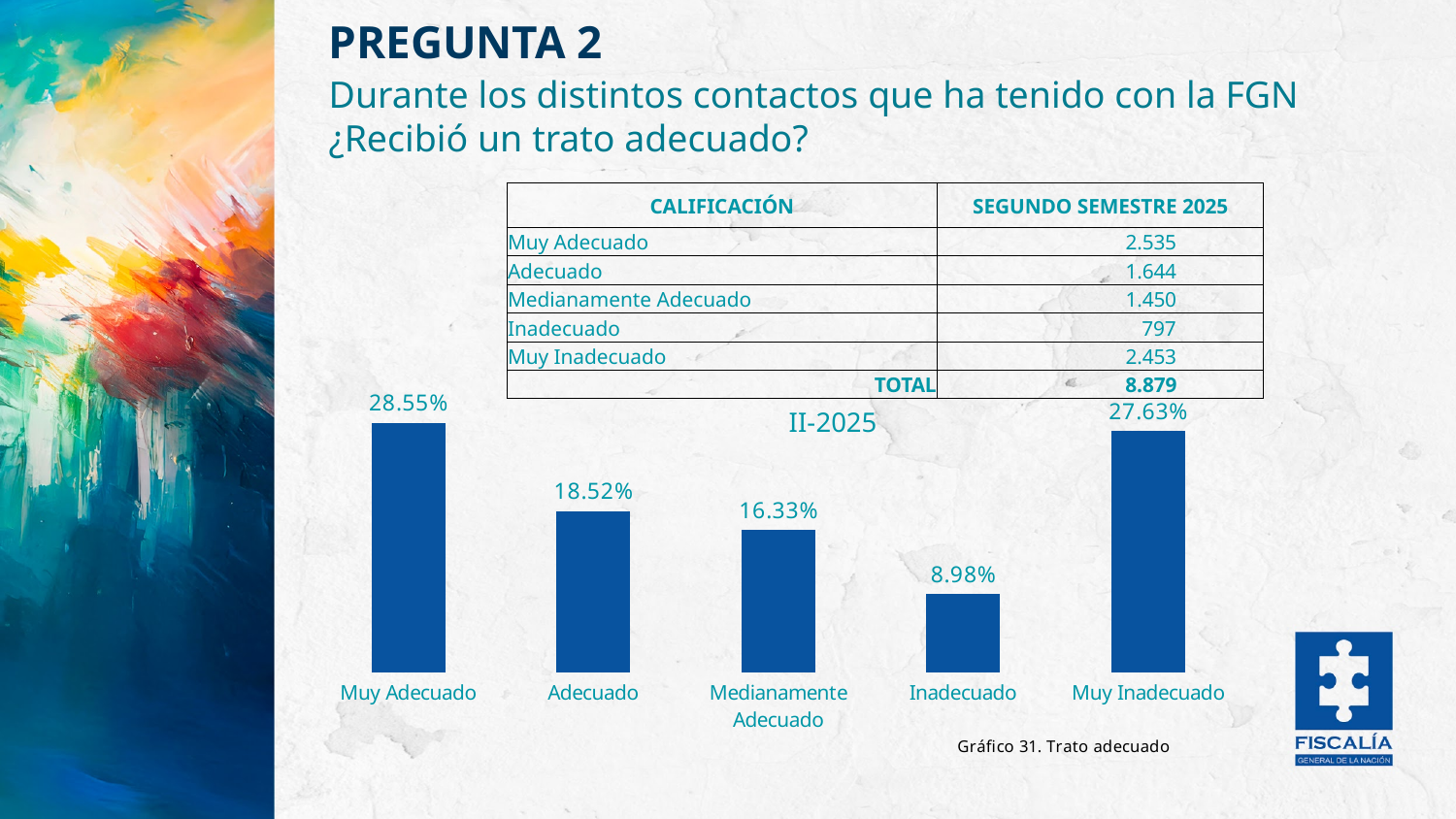
How many categories are shown in the bar chart? 5 What is the difference between the values for Muy Adecuado and Inadecuado in the bar chart? 19.57% Which category has the lowest value in the bar chart? Inadecuado Which is larger in the bar chart, the value for Adecuado or the value for Muy Inadecuado? Muy Inadecuado What kind of chart is shown on the slide? Bar chart What is the value for Medianamente Adecuado in the bar chart? 16.33% What is the value for Muy Inadecuado in the bar chart? 27.63% What is the title of the bar chart? II-2025 What is the value for Inadecuado in the bar chart? 8.98% Which category has the highest value in the bar chart? Muy Adecuado What is the difference between the values for Adecuado and Medianamente Adecuado in the bar chart? 2.19% What is the value for Muy Adecuado in the bar chart? 28.55%